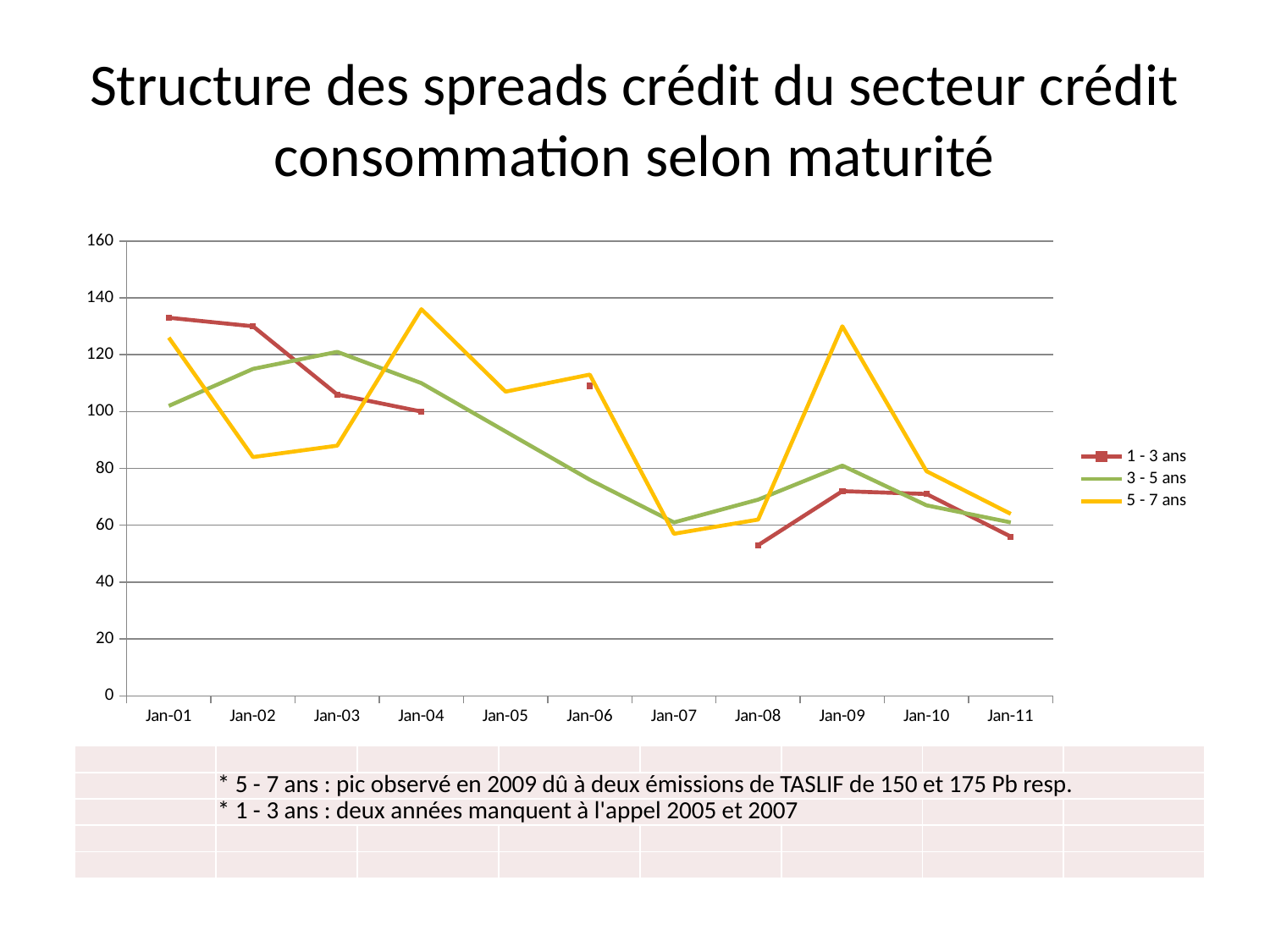
Is the value for 5 - 7 ans at Jan-04 greater or less than 120? greater Is the value for 1 - 3 ans at Jan-08 greater or less than 60? less What colour is the line for the 5 - 7 ans series? yellow Which series has the highest value at Jan-04? 5 - 7 ans Does the 1 - 3 ans series rise or fall from Jan-01 to Jan-04? fall Is the value for 3 - 5 ans at Jan-07 greater or less than 80? less What kind of chart is shown on the slide? line chart At Jan-02, which is higher: 1 - 3 ans or 5 - 7 ans? 1 - 3 ans How many points are shown along the x axis (from Jan-01 to Jan-11)? 11 Which series has the lowest value at Jan-01? 3 - 5 ans How many series does the legend list? 3